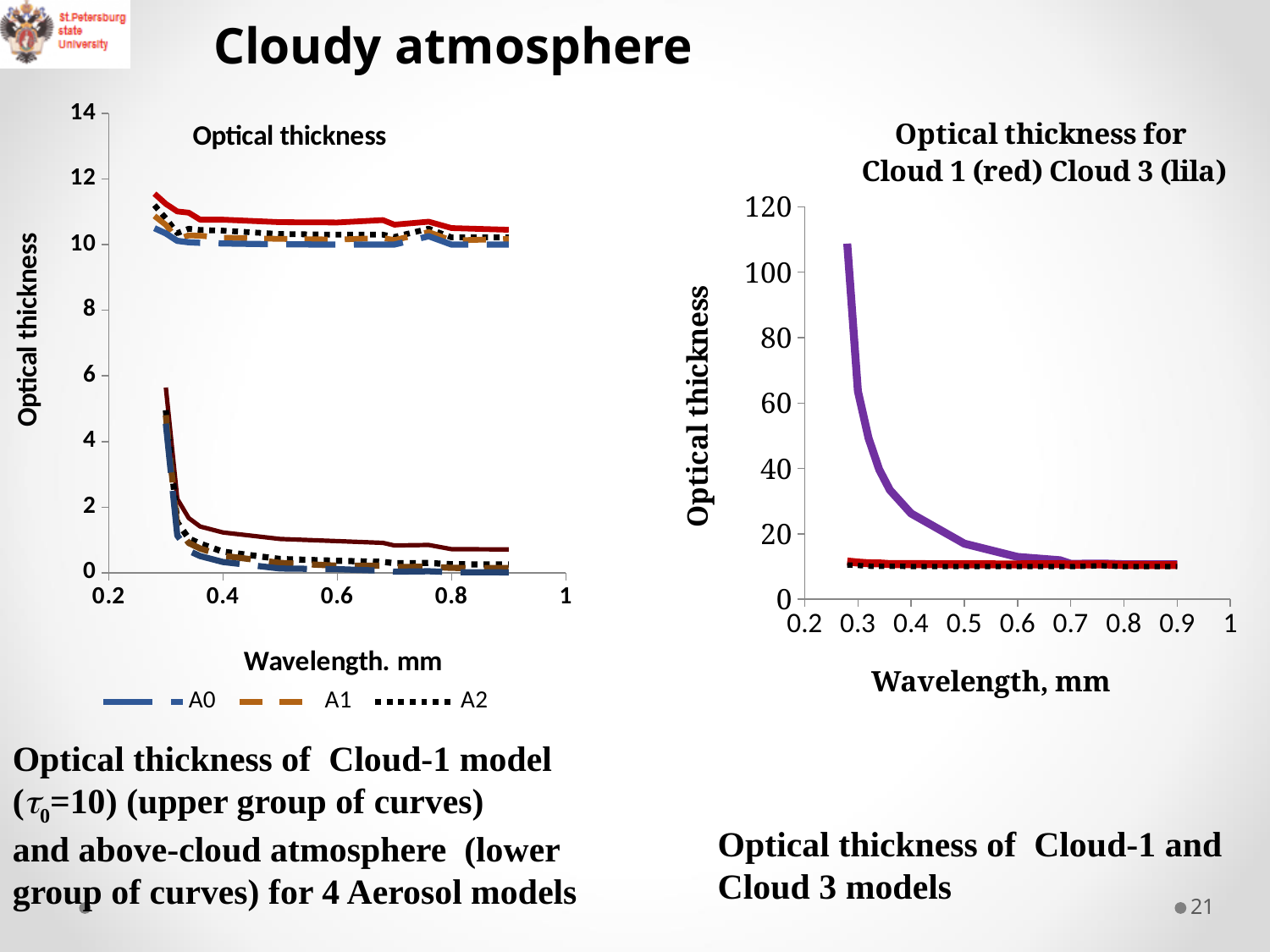
What is the x-axis label of the right chart? Wavelength, mm In the right chart, does the lila (purple) Cloud 3 curve rise or fall as wavelength increases? fall In the left chart 'Optical thickness', how many series does the legend list? 3 In the right chart, is the value of the red Cloud 1 curve at wavelength 0.9 greater or less than 20? less What kind of chart is the left chart titled 'Optical thickness'? line chart In the left chart 'Optical thickness', does the lower group of curves rise or fall as wavelength increases from 0.3 to 0.9? fall What kind of chart is the right chart titled 'Optical thickness for Cloud 1 (red) Cloud 3 (lila)'? line chart In the right chart, is the value of the lila (purple) Cloud 3 curve at wavelength 0.4 greater or less than 40? less In the left chart 'Optical thickness', what are the series names listed in the legend? A0, A1, A2 In the left chart 'Optical thickness', is the value of the upper group of curves at wavelength 0.6 greater or less than 8? greater